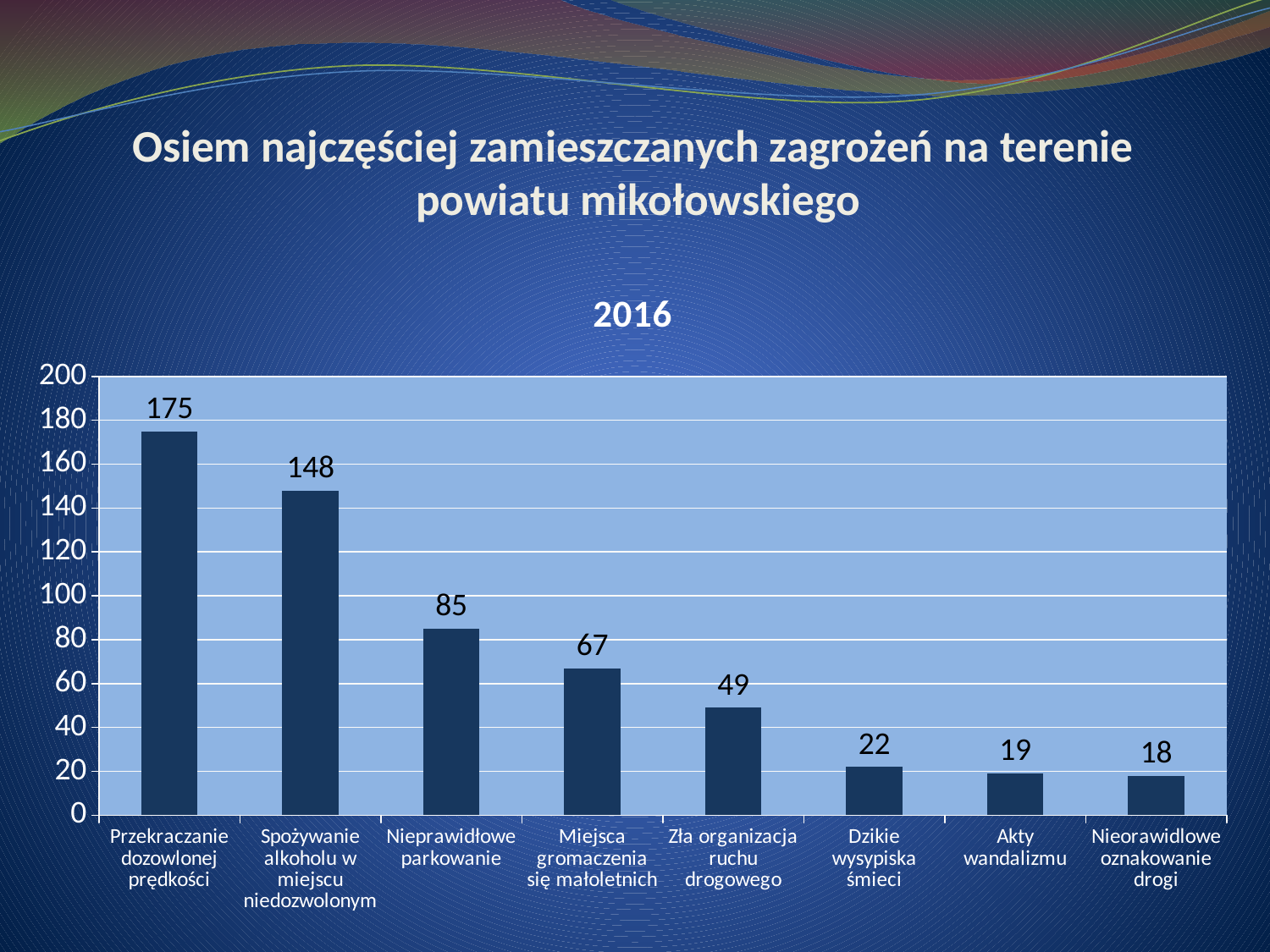
Which category has the lowest value? Nieorawidlowe oznakowanie drogi What year is shown as the chart title? 2016 Which category has the highest value? Przekraczanie dozwolonej prędkości How many categories are shown on the chart? 8 What is the value for Przekraczanie dozwolonej prędkości? 175 Do the values rise or fall from left to right along the x axis? fall What is the difference between the values for Spożywanie alkoholu w miejscu niedozwolonym and Miejsca gromaczenia się małoletnich? 81 What is the value for Dzikie wysypiska śmieci? 22 What kind of chart is shown on the slide? bar chart Which is larger, the value for Zła organizacja ruchu drogowego or the value for Akty wandalizmu? Zła organizacja ruchu drogowego Is the value for Spożywanie alkoholu w miejscu niedozwolonym greater or less than 140? greater What is the value for Nieprawidłowe parkowanie? 85